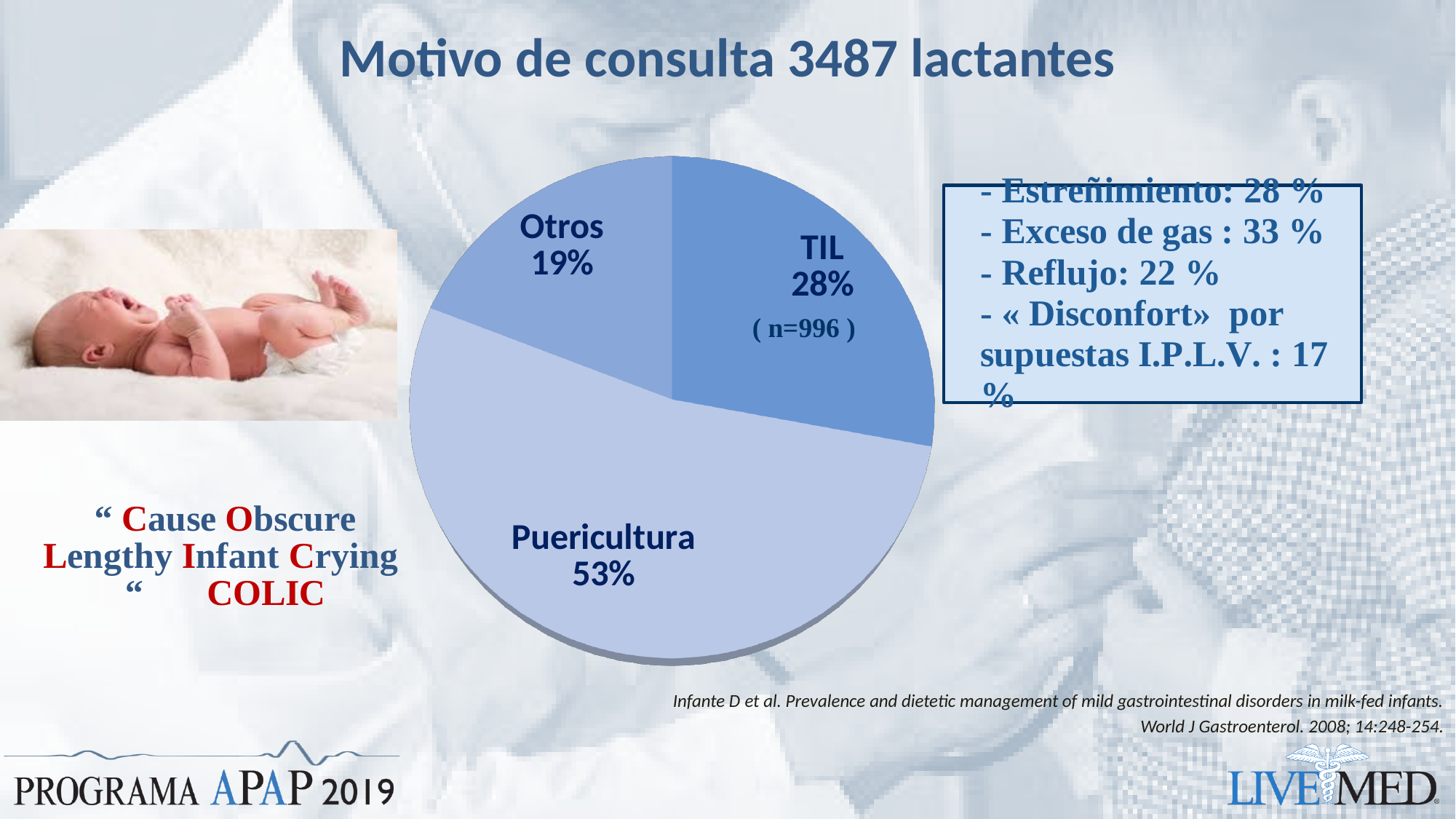
Which is larger, the TIL slice or the Otros slice? TIL Which slice of the pie is the largest? Puericultura What share of the pie does TIL represent? 28% How many slices does the pie chart have? 3 What share of the pie does Puericultura represent? 53% What share of the pie does Otros represent? 19% What is the difference in percentage points between Puericultura and TIL? 25 What is the n value shown for the TIL slice? n=996 What is the difference in percentage points between TIL and Otros? 9 Which slice of the pie is the smallest? Otros What is the title of the slide containing the pie chart? Motivo de consulta 3487 lactantes What kind of chart is shown on the slide? pie chart